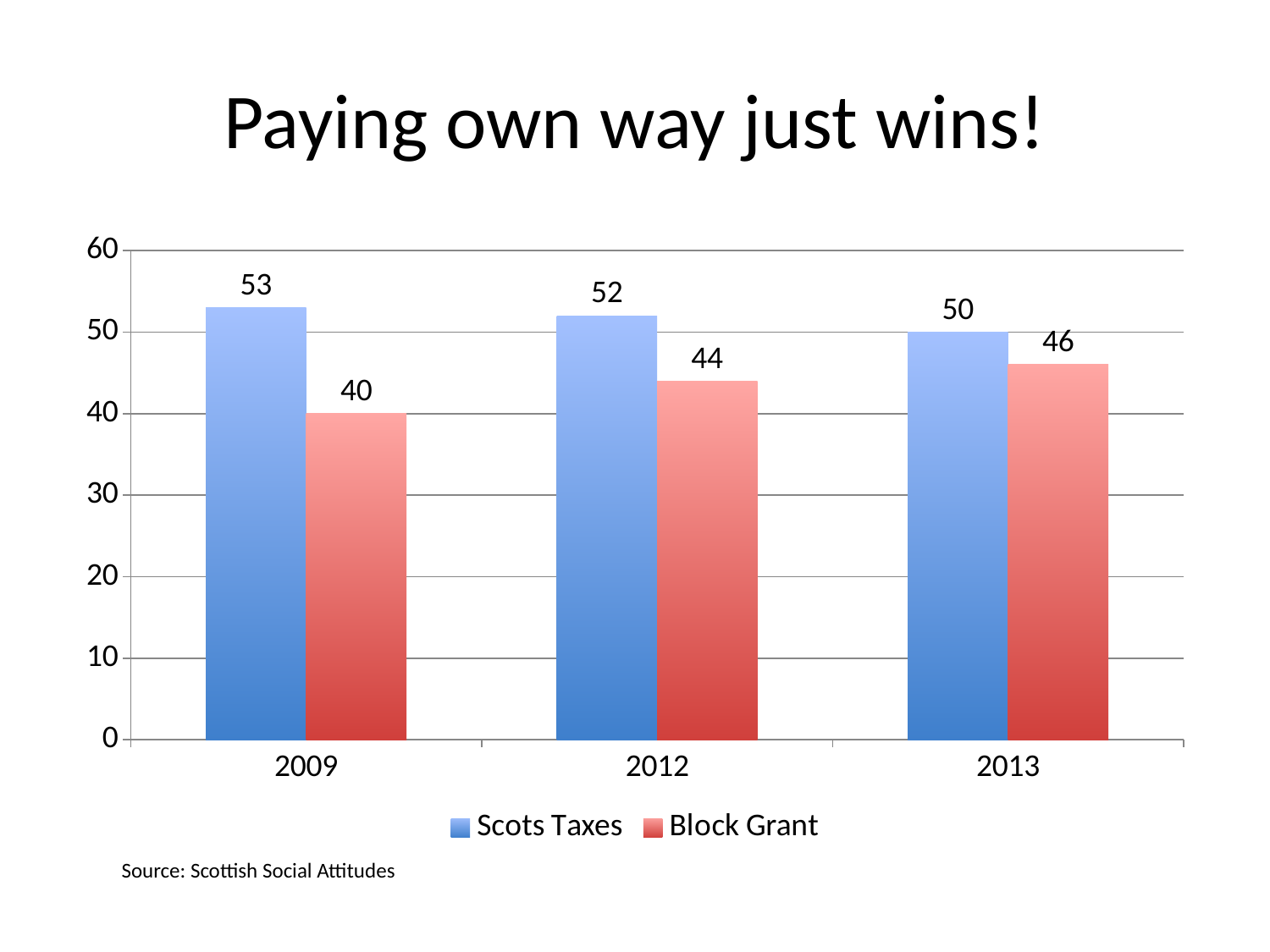
What is the value for Block Grant in 2013? 46 How many years are shown on the x axis? 3 What is the value for Block Grant in 2012? 44 What is the difference between Scots Taxes and Block Grant in 2009? 13 In which year is the Block Grant value lowest? 2009 How many series does the legend list? 2 What kind of chart is shown on the slide? Bar chart Which is larger in 2012, Scots Taxes or Block Grant? Scots Taxes In which year is the Scots Taxes value highest? 2009 What is the value for Scots Taxes in 2009? 53 Do the Block Grant values rise or fall from 2009 to 2013? Rise What is the difference between Scots Taxes and Block Grant in 2013? 4